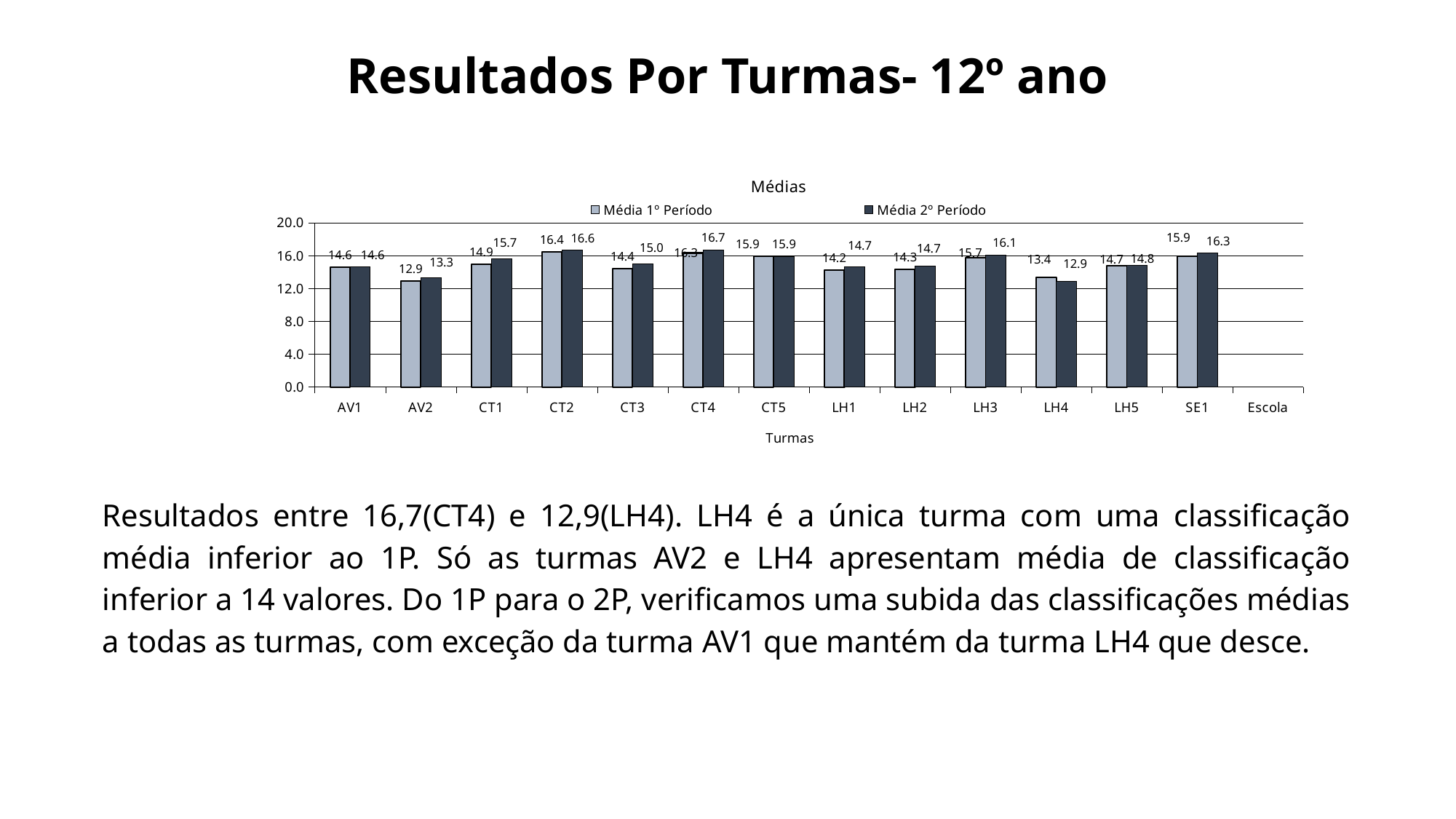
What is the Média 2º Período value for LH4? 12.9 What kind of chart is shown on the slide? bar chart Is the Média 2º Período value for AV2 greater or less than 16.0? less How many series does the legend list? 2 What is the difference between the Média 2º Período and Média 1º Período for CT1? 0.8 What is the title of the chart? Médias What is the Média 1º Período value for CT4? 16.3 Which turma has the lowest Média 1º Período? AV2 Which turma has the highest Média 2º Período? CT4 What is the label of the x axis? Turmas Which is larger for LH4: Média 1º Período or Média 2º Período? Média 1º Período What is the Média 2º Período value for SE1? 16.3